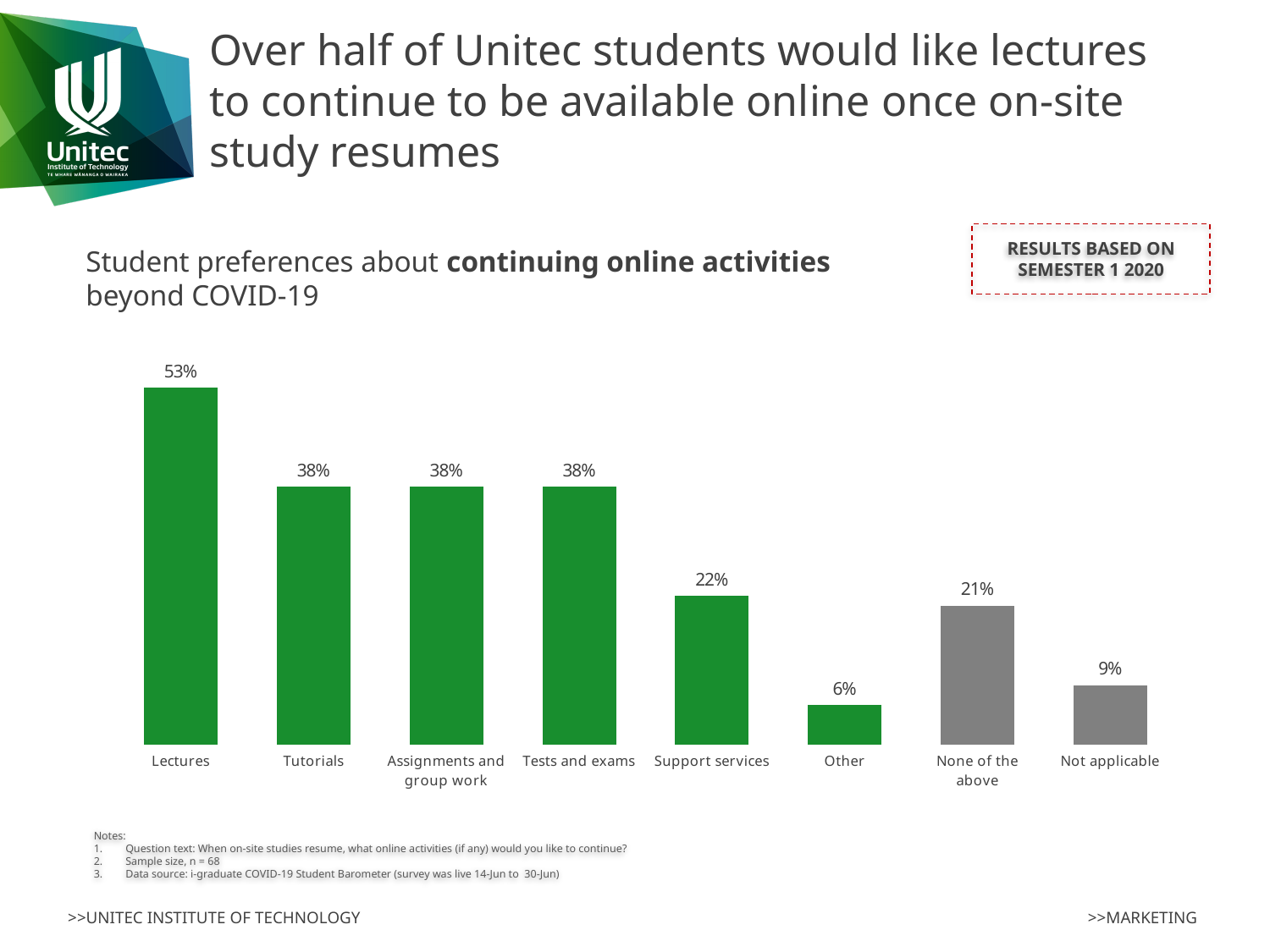
Which category has the highest value? Lectures What kind of chart is shown on the slide? Bar chart What is the difference between the values for Support services and Other? 16 percentage points How many categories are shown on the x axis? 8 Which is larger, the value for Not applicable or the value for Other? Not applicable Which category has the lowest value? Other What percentage of students would like lectures to continue online? 53% What is the value for Support services? 22% What is the value for None of the above? 21% What is the difference between the values for Lectures and Tutorials? 15 percentage points How many categories share the value 38%? 3 Which two categories are shown with grey bars instead of green? None of the above and Not applicable